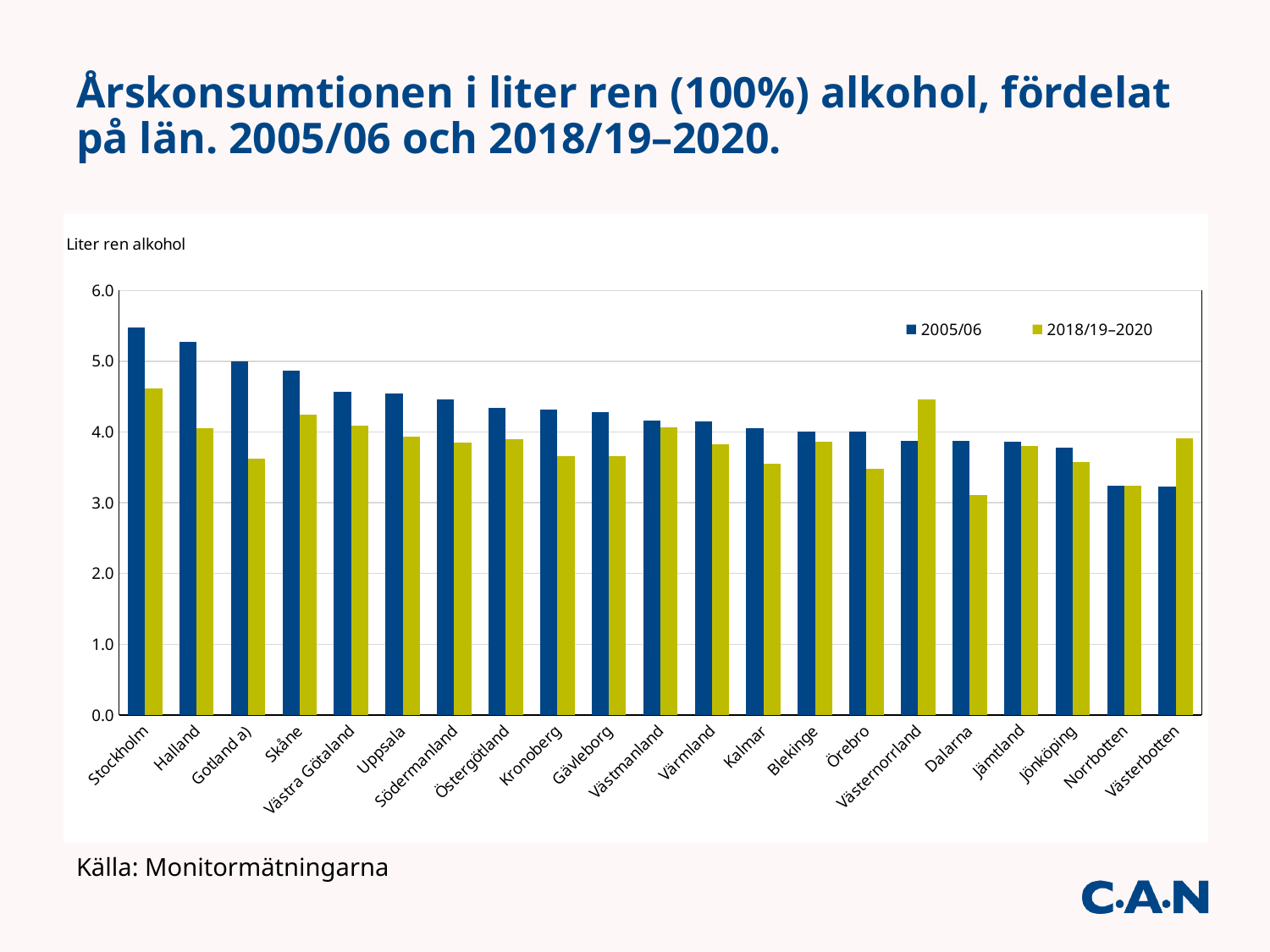
What is the label shown above the y axis of the chart? Liter ren alkohol Is the 2018/19–2020 value for Västernorrland greater or less than 4.0? greater For Västernorrland, which series has the larger value, 2005/06 or 2018/19–2020? 2018/19–2020 How many counties (categories) are shown on the x axis? 21 Is the 2005/06 value for Stockholm greater or less than 5.0? greater How many series does the legend list? 2 What kind of chart is shown on the slide? bar chart For Stockholm, which series has the larger value, 2005/06 or 2018/19–2020? 2005/06 Which county has the highest value for the 2005/06 series? Stockholm Is the 2018/19–2020 value for Gotland a) greater or less than 4.0? less Do the 2005/06 values generally rise or fall from left to right along the x axis? fall